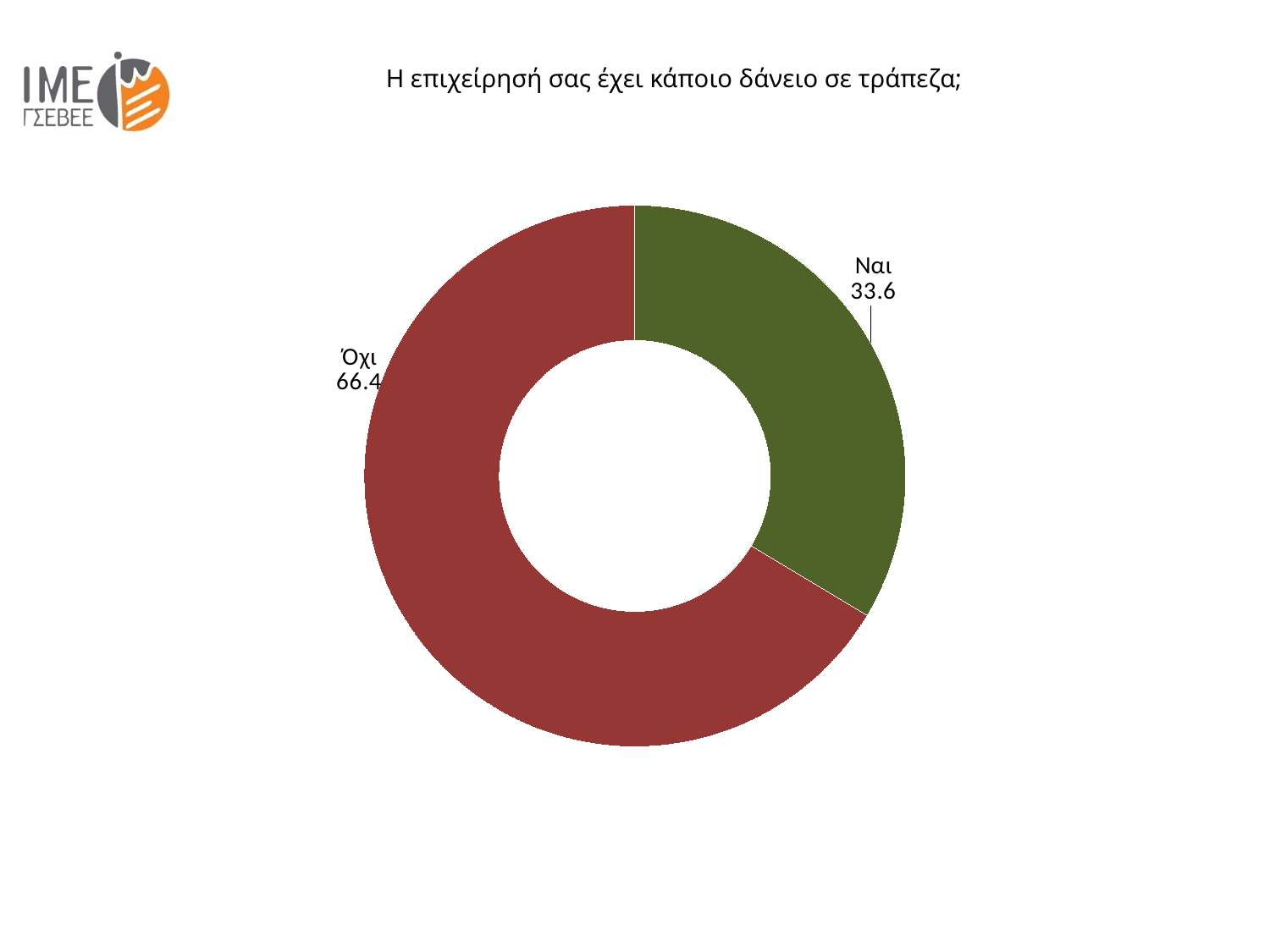
What is the value for Όχι? 66.4 What kind of chart is shown on the slide? Doughnut chart What is the total of the two values shown in the chart? 100 How many categories are shown in the chart? 2 What is the difference between the values for Όχι and Ναι? 32.8 Which is larger, the value for Ναι or the value for Όχι? Όχι What is the title of the chart? Η επιχείρησή σας έχει κάποιο δάνειο σε τράπεζα; What is the value for Ναι? 33.6 What colour is the Ναι segment? Green Which category has the smallest share? Ναι Which category has the largest share? Όχι